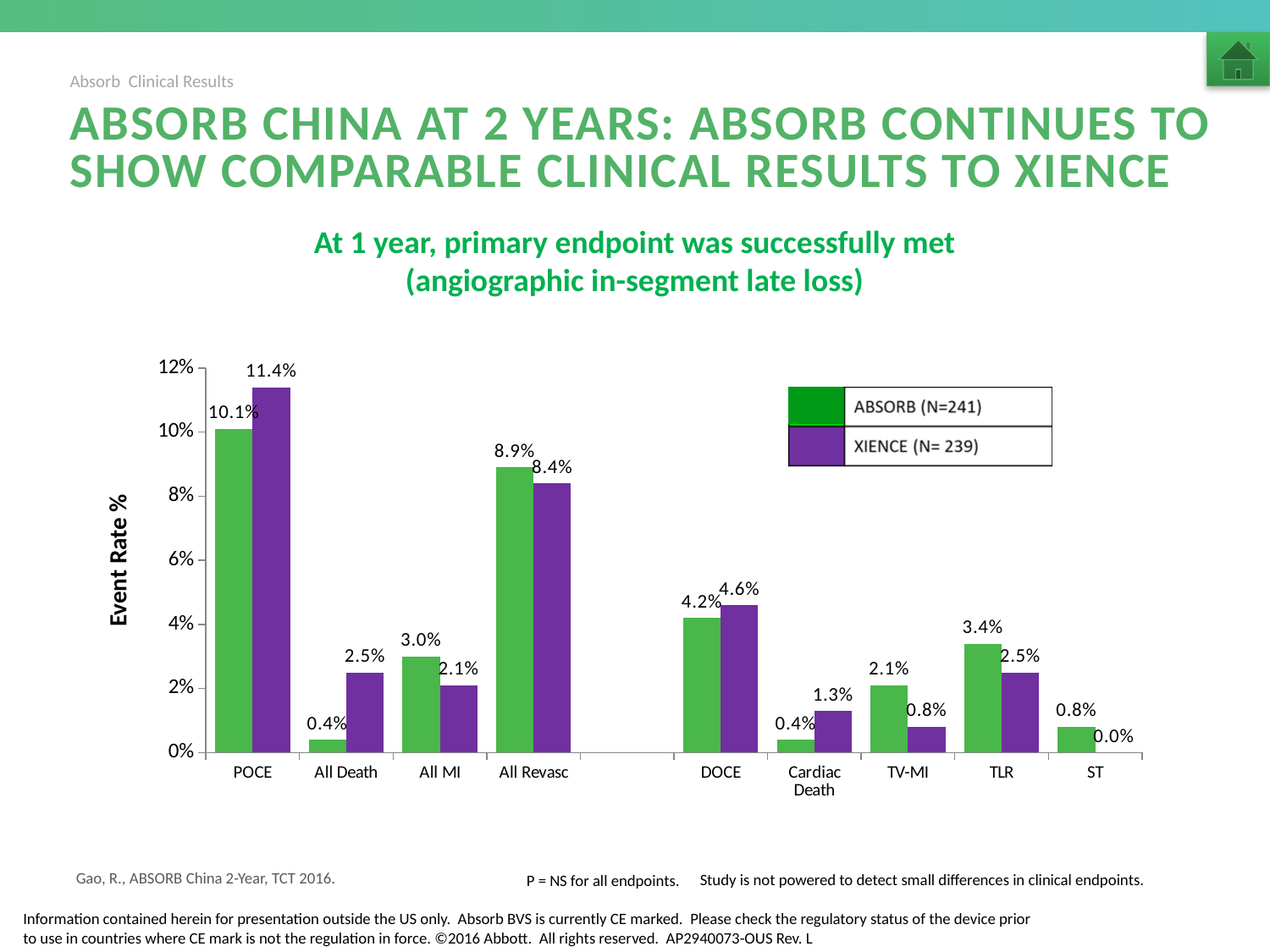
Which category has the highest XIENCE event rate? POCE What is the ABSORB event rate for TLR? 3.4% What is the XIENCE event rate for All Death? 2.5% What is the ABSORB event rate for POCE? 10.1% What is the XIENCE event rate for ST? 0.0% How many categories are shown on the x axis of the chart? 9 What is the difference between the XIENCE and ABSORB event rates for POCE? 1.3% For DOCE, which has the higher event rate, ABSORB or XIENCE? XIENCE How many series does the legend list? 2 What type of chart is shown on the slide? Bar chart Which category has the lowest XIENCE event rate? ST What is the difference between the ABSORB and XIENCE event rates for TV-MI? 1.3%